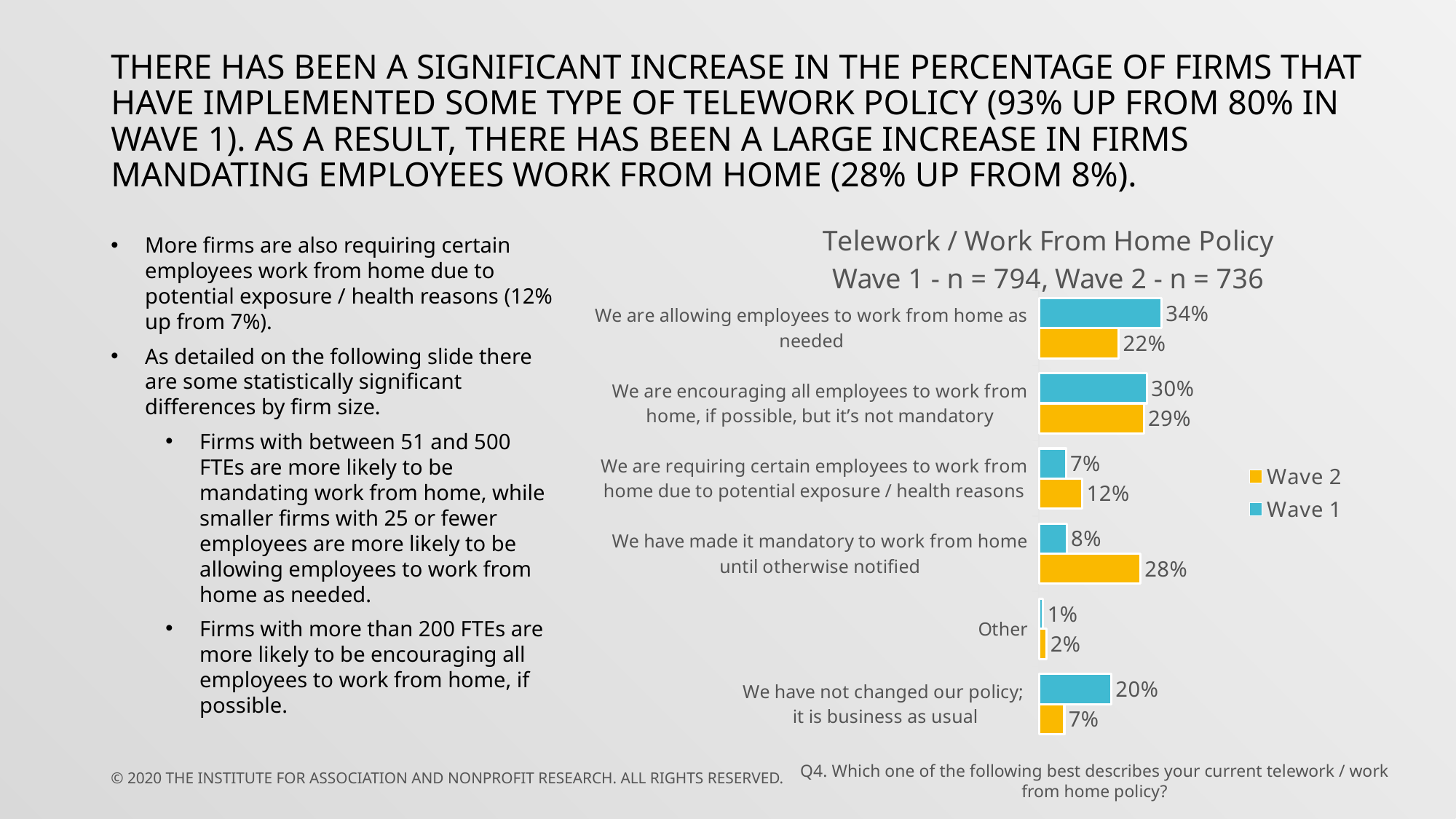
Which category has the highest Wave 1 value? We are allowing employees to work from home as needed Which is larger for "We have not changed our policy; it is business as usual": the Wave 1 value or the Wave 2 value? Wave 1 What is the Wave 2 value for "We have not changed our policy; it is business as usual"? 7% What colour represents Wave 2 in the chart? Yellow What is the Wave 2 value for "We have made it mandatory to work from home until otherwise notified"? 28% What is the difference between the Wave 1 and Wave 2 values for "We are allowing employees to work from home as needed"? 12% Which category has the lowest Wave 2 value? Other How many categories are shown in the chart? 6 How many series does the legend list? 2 What is the Wave 1 value for "We are allowing employees to work from home as needed"? 34% What is the difference between the Wave 2 and Wave 1 values for "We have made it mandatory to work from home until otherwise notified"? 20% What kind of chart is shown on the slide? Bar chart